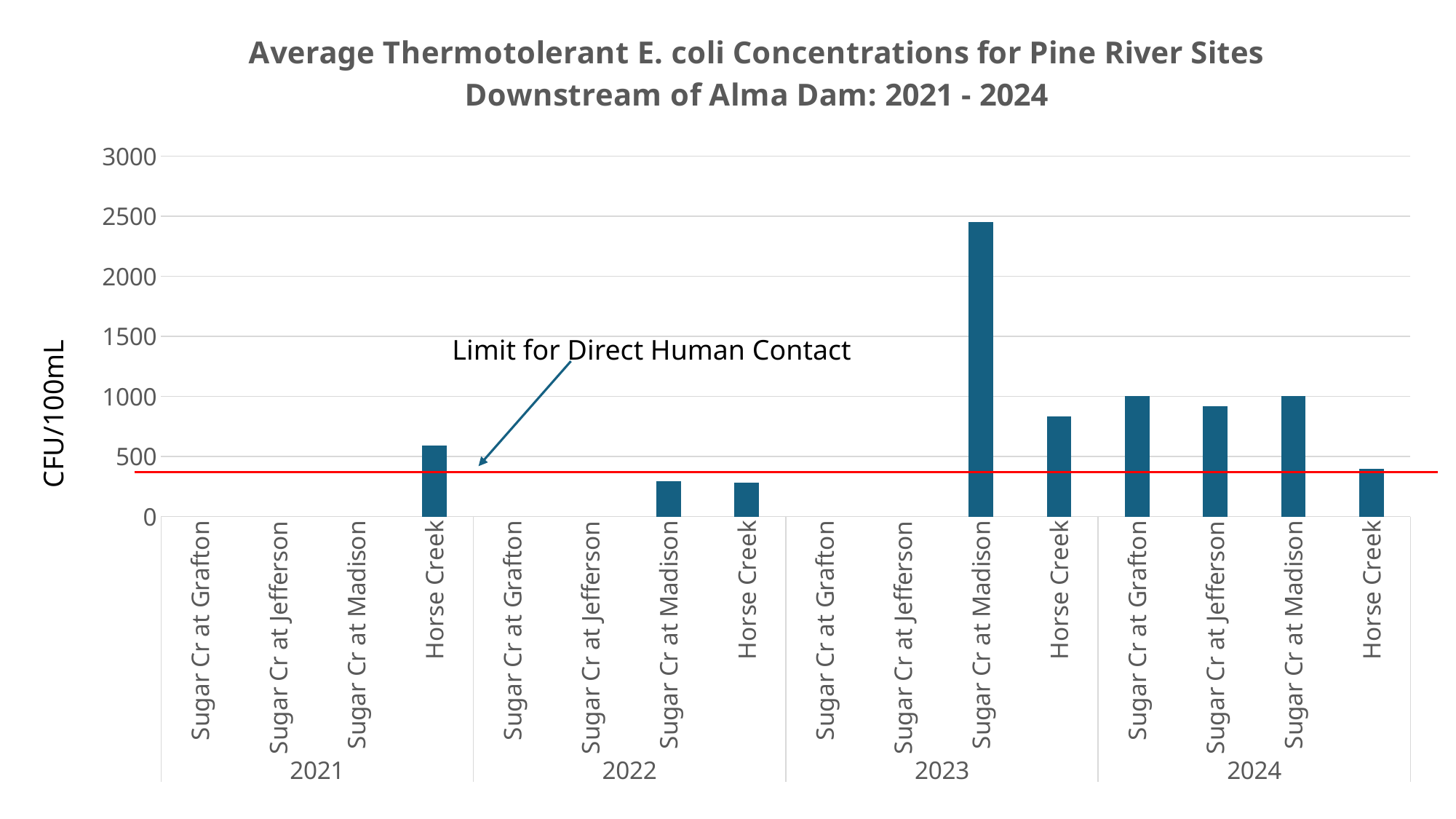
How many year groups are shown along the x axis? 4 Which site and year has the highest average E. coli concentration? Sugar Cr at Madison, 2023 Which is larger: the value for Horse Creek in 2021 or Horse Creek in 2022? Horse Creek in 2021 What kind of chart is shown on the slide? Bar chart Is the value for Horse Creek in 2023 greater or less than 1000? less Is the value for Sugar Cr at Madison in 2023 greater or less than 2000? greater What is the label on the y axis? CFU/100mL Is the value for Sugar Cr at Madison in 2022 greater or less than 500? less Which is larger: the value for Sugar Cr at Madison in 2023 or Horse Creek in 2023? Sugar Cr at Madison in 2023 What does the red horizontal line represent, according to the annotation? Limit for Direct Human Contact How many site labels are listed along the x axis in total? 16